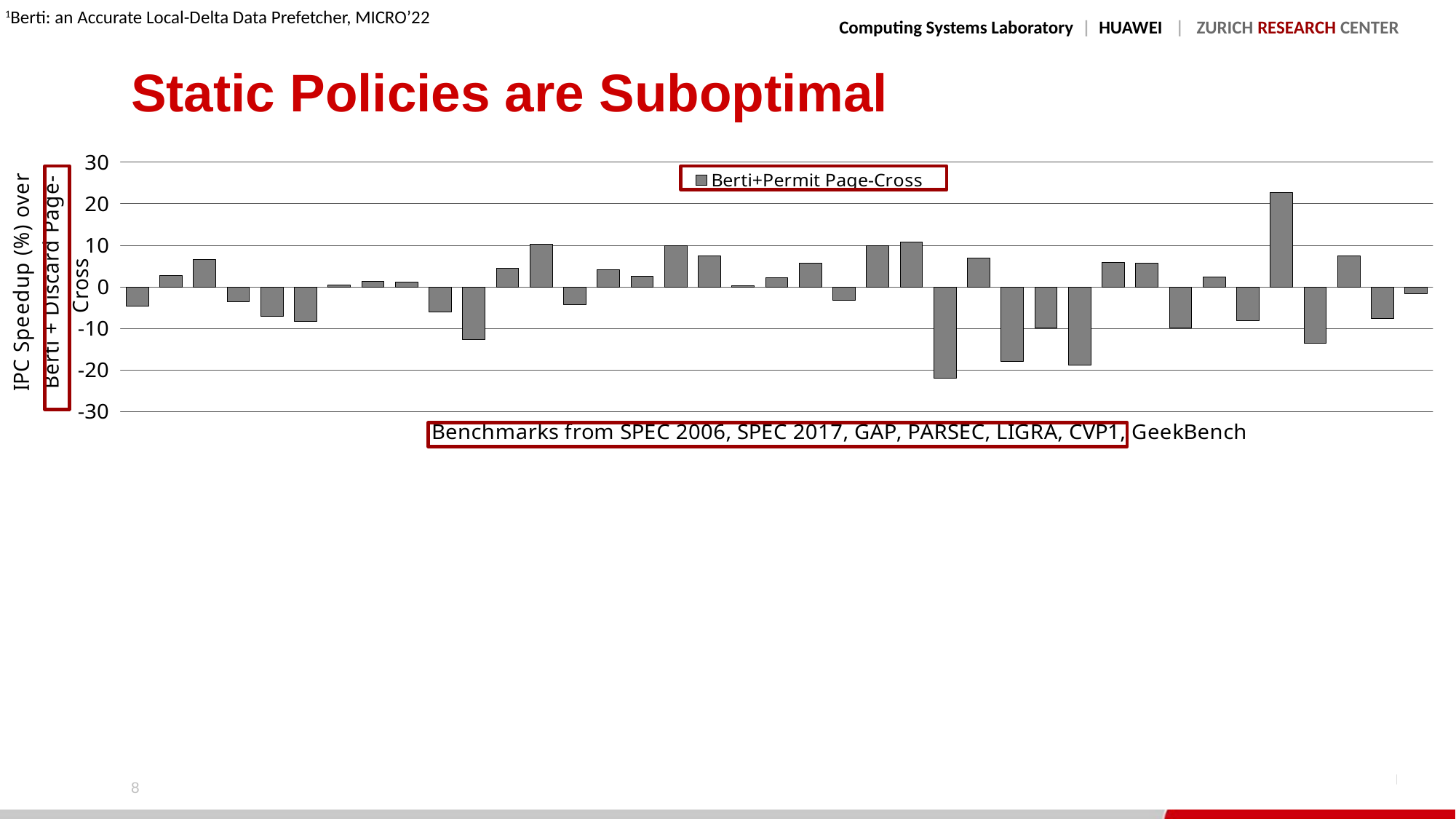
Is the value of the tallest bar in the chart greater or less than 20? greater Is the value of the tallest bar in the chart greater or less than 30? less How many series does the chart's legend list? 1 Is the value of the lowest bar in the chart greater or less than -20? less What is the label of the chart's vertical axis? IPC Speedup (%) over Berti + Discard Page-Cross What is the name of the series shown in the chart's legend? Berti+Permit Page-Cross What kind of chart is shown on the slide? bar chart